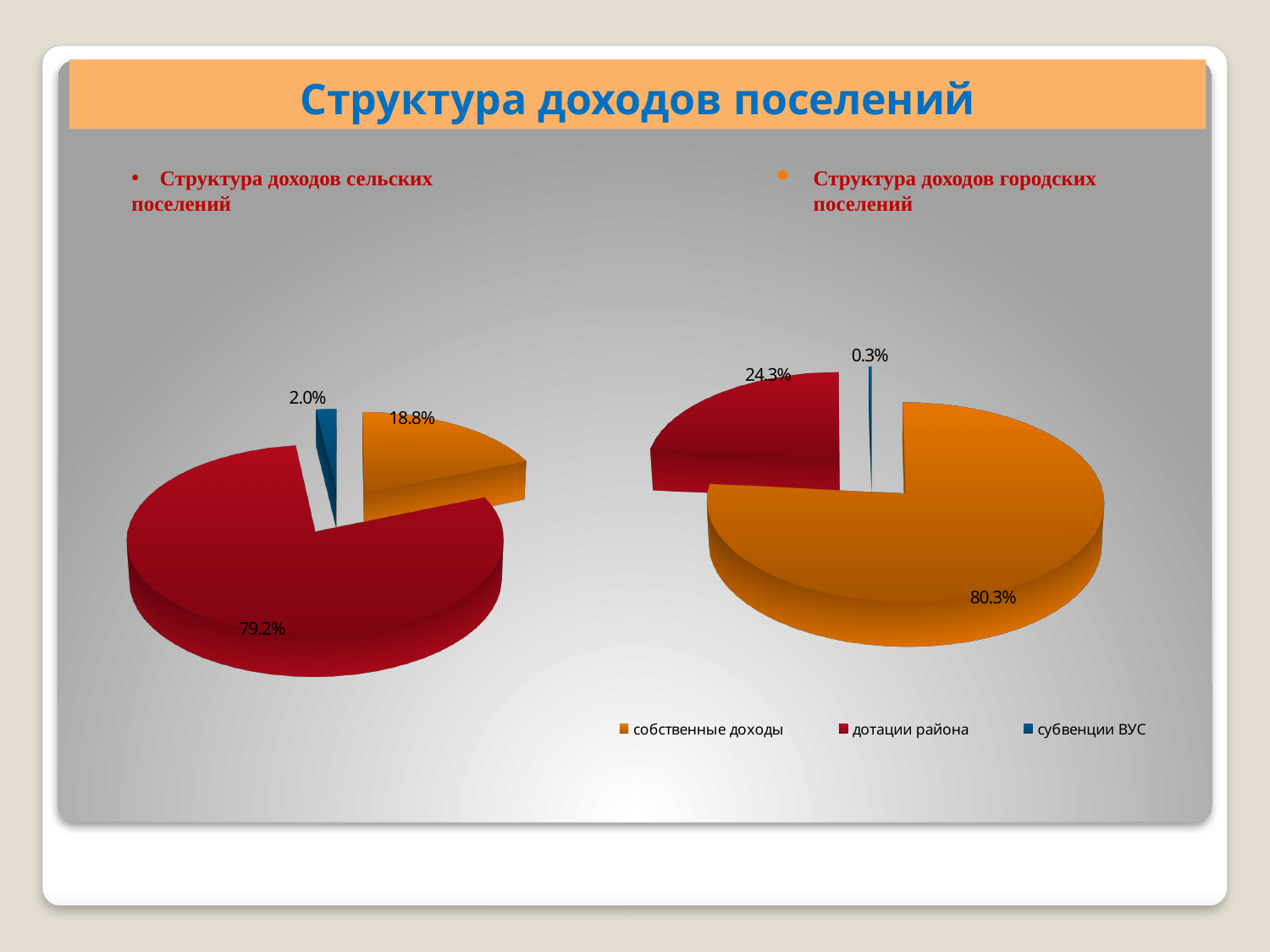
Which is larger: the share for собственные доходы in the left chart (сельских поселений) or in the right chart (городских поселений)? the right chart (городских поселений) In the right pie chart (Структура доходов городских поселений), which category has the smallest slice? субвенции ВУС In the left pie chart (Структура доходов сельских поселений), what is the share for дотации района? 79.2% In the right pie chart (Структура доходов городских поселений), what is the share for дотации района? 24.3% How many series does the legend list? 3 In the left pie chart (Структура доходов сельских поселений), what is the share for субвенции ВУС? 2.0% In the right pie chart (Структура доходов городских поселений), what is the share for субвенции ВУС? 0.3% In the left pie chart (Структура доходов сельских поселений), what is the share for собственные доходы? 18.8% In the left pie chart (Структура доходов сельских поселений), which category has the largest slice? дотации района In the left pie chart (Структура доходов сельских поселений), what is the difference between the shares for дотации района and собственные доходы? 60.4% What kind of chart is used on this slide? pie chart In the right pie chart (Структура доходов городских поселений), what is the share for собственные доходы? 80.3%